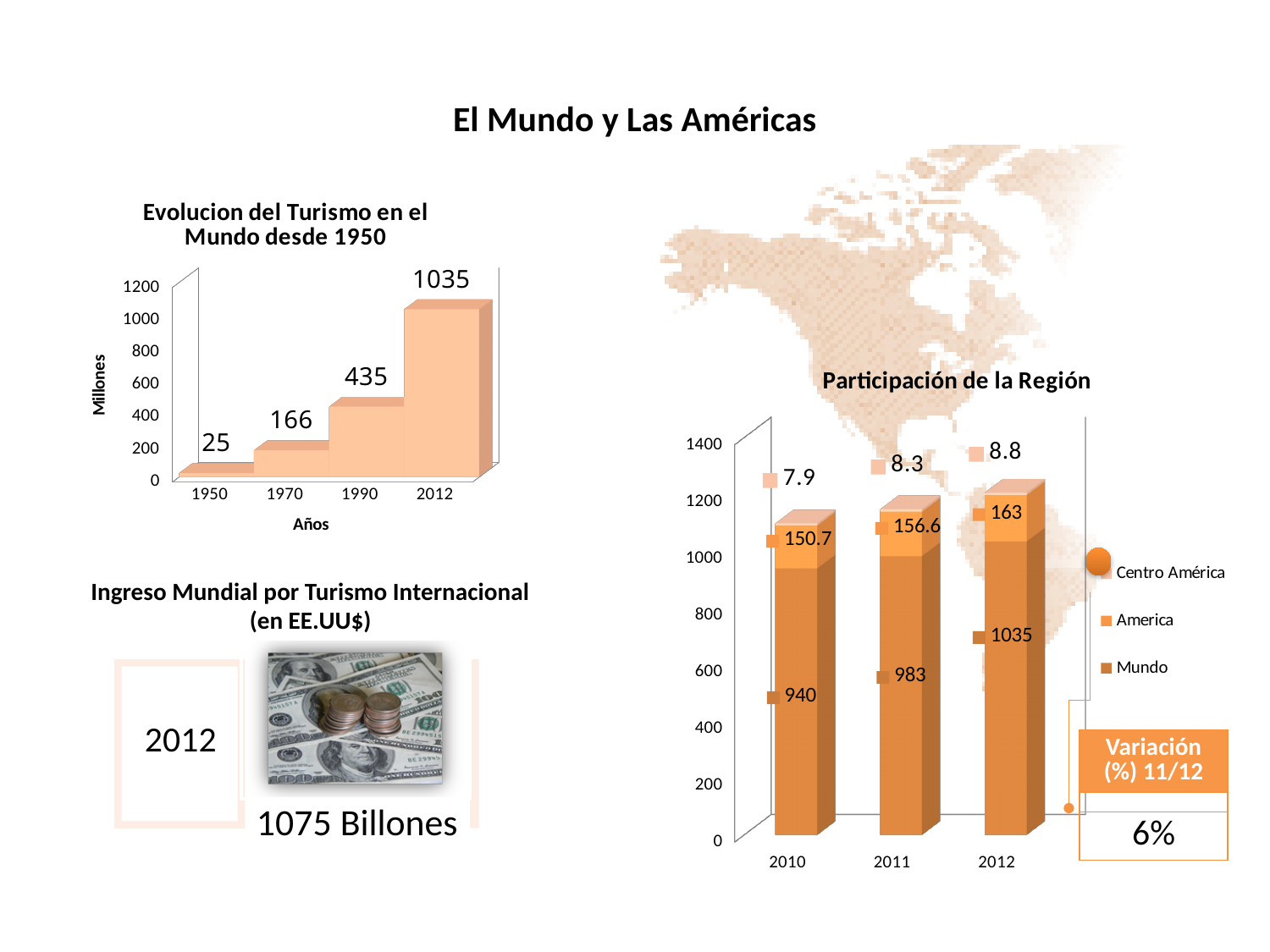
In the chart 'Evolucion del Turismo en el Mundo desde 1950', do the values rise or fall from 1950 to 2012? rise In the chart 'Participación de la Región', what is the total of the stacked bar for 2010? 1098.6 In the chart 'Participación de la Región', what is the value for Centro América in 2010? 7.9 In the chart 'Participación de la Región', what is the value for Mundo in 2011? 983 In the chart 'Evolucion del Turismo en el Mundo desde 1950', which year has the lowest value? 1950 In the chart 'Evolucion del Turismo en el Mundo desde 1950', what is the label of the vertical axis? Millones In the chart 'Evolucion del Turismo en el Mundo desde 1950', what is the value for 1970? 166 In the chart 'Evolucion del Turismo en el Mundo desde 1950', what is the value for 2012? 1035 In the chart 'Evolucion del Turismo en el Mundo desde 1950', how many years are shown on the x axis? 4 In the chart 'Participación de la Región', how many series does the legend list? 3 In the chart 'Participación de la Región', what is the value for America in 2012? 163 In the chart 'Evolucion del Turismo en el Mundo desde 1950', what is the difference between the values for 1990 and 1970? 269